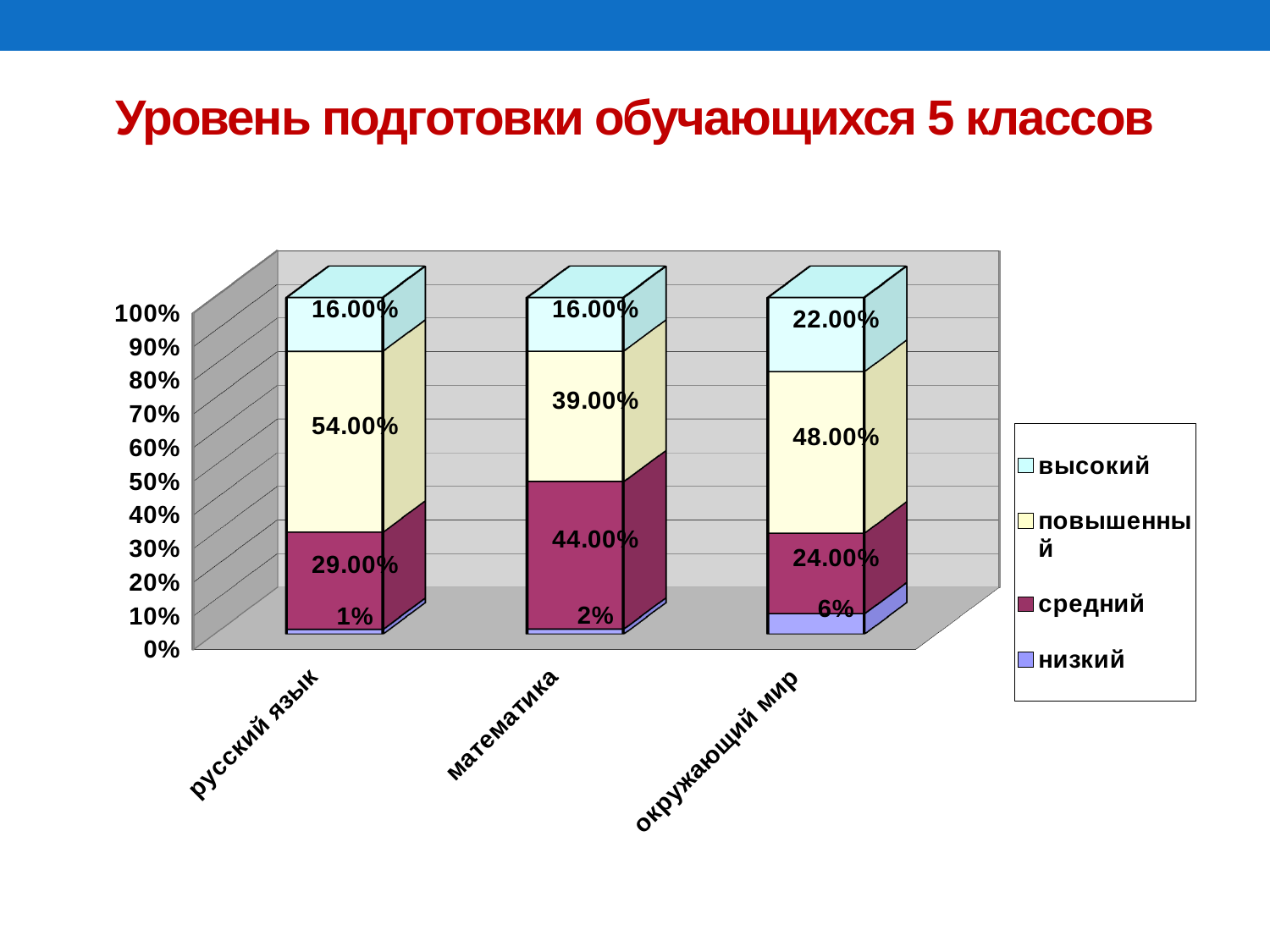
What is the value of the повышенный segment for русский язык? 54.00% What is the value of the средний segment for математика? 44.00% What is the difference between the повышенный values for русский язык and математика? 15.00% What kind of chart is shown on the slide? stacked bar chart Which category has the lowest value for the низкий series? русский язык What is the title of the slide? Уровень подготовки обучающихся 5 классов How many categories are shown on the x axis? 3 How many series does the legend list? 4 Which is larger: the высокий value for математика or the высокий value for окружающий мир? окружающий мир What is the value of the высокий segment for окружающий мир? 22.00% What is the value of the низкий segment for окружающий мир? 6% Which category has the highest value for the средний series? математика